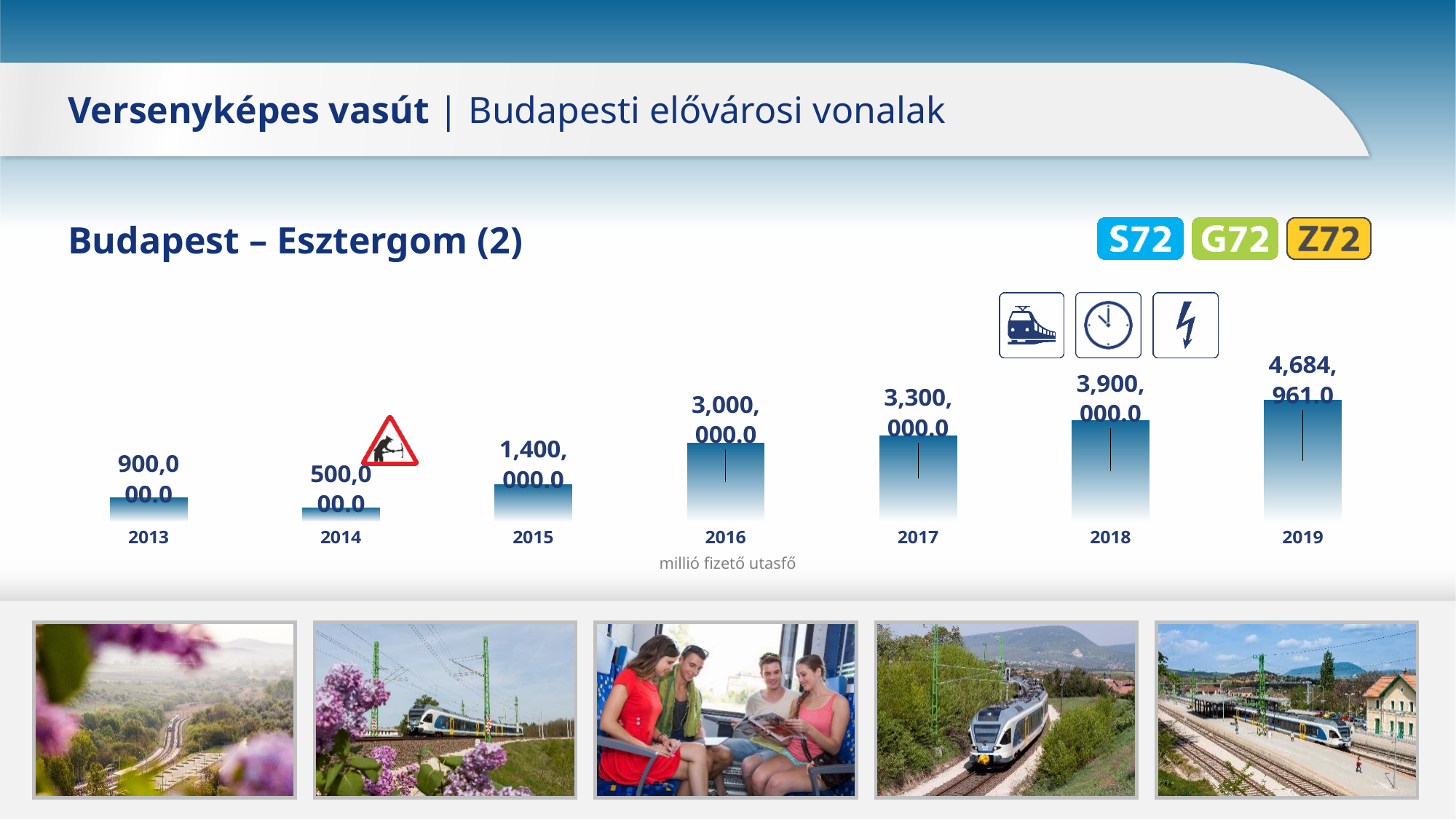
Which is larger, the value for 2016 or the value for 2017? 2017 What is the value for 2015? 1,400,000.0 Which year has the highest value? 2019 Which year has the lowest value? 2014 What is the difference between the values for 2013 and 2014? 400,000.0 What is the value for 2019? 4,684,961.0 What is the difference between the values for 2018 and 2017? 600,000.0 What kind of chart is shown? bar chart How many years are shown on the x axis? 7 Do the values rise or fall from 2014 to 2019? rise What is the value for 2013? 900,000.0 What is the value for 2016? 3,000,000.0